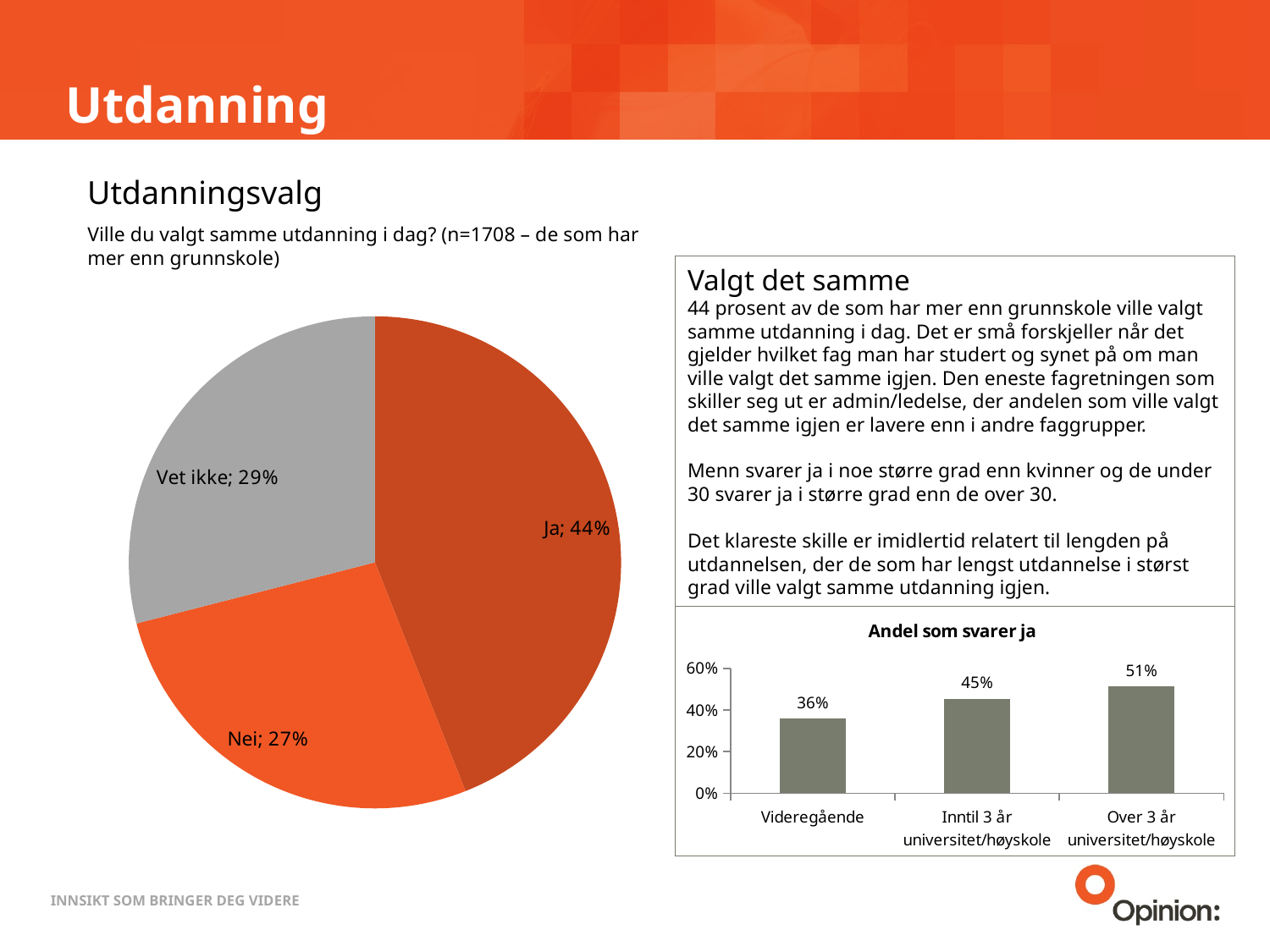
In the "Andel som svarer ja" chart, which category has the highest value? Over 3 år universitet/høyskole In the pie chart on the left, what share of respondents answered "Ja"? 44% In the "Andel som svarer ja" chart, what is the value for "Over 3 år universitet/høyskole"? 51% In the pie chart on the left, which answer has the smallest share? Nei In the pie chart on the left, how many slices are there? 3 In the pie chart on the left, what share of respondents answered "Vet ikke"? 29% What kind of chart is the "Andel som svarer ja" chart? bar chart In the pie chart on the left, what is the difference between the "Ja" share and the "Nei" share? 17 percentage points In the pie chart on the left, what share of respondents answered "Nei"? 27% In the "Andel som svarer ja" chart, do the values rise or fall from left to right? rise In the pie chart on the left, which answer has the largest share? Ja In the "Andel som svarer ja" chart, what is the value for "Videregående"? 36%